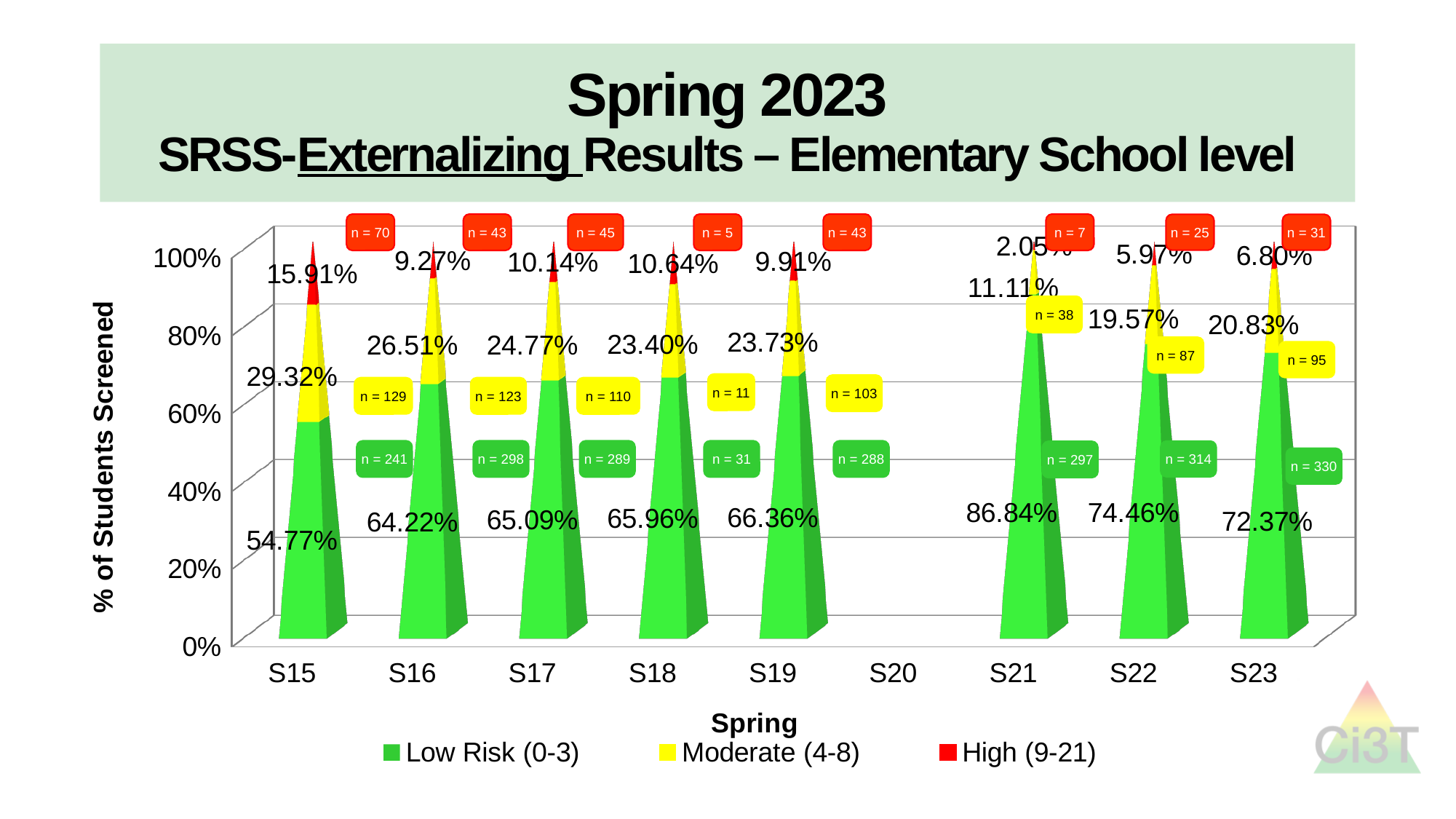
Which spring has the lowest Low Risk (0-3) percentage? S15 What kind of chart is shown on the slide? Stacked bar chart What is the n value shown for the Low Risk (0-3) group in S23? n = 330 How many spring labels are shown on the x axis? 9 Which spring has the highest Low Risk (0-3) percentage? S21 What is the Moderate (4-8) percentage for S22? 19.57% What is the Low Risk (0-3) percentage for S21? 86.84% What is the High (9-21) percentage for S15? 15.91% What is the difference between the Low Risk (0-3) percentages for S21 and S22? 12.38% Which is larger, the Moderate (4-8) percentage for S16 or for S17? S16 What is the label of the y axis? % of Students Screened How many series does the legend list? 3